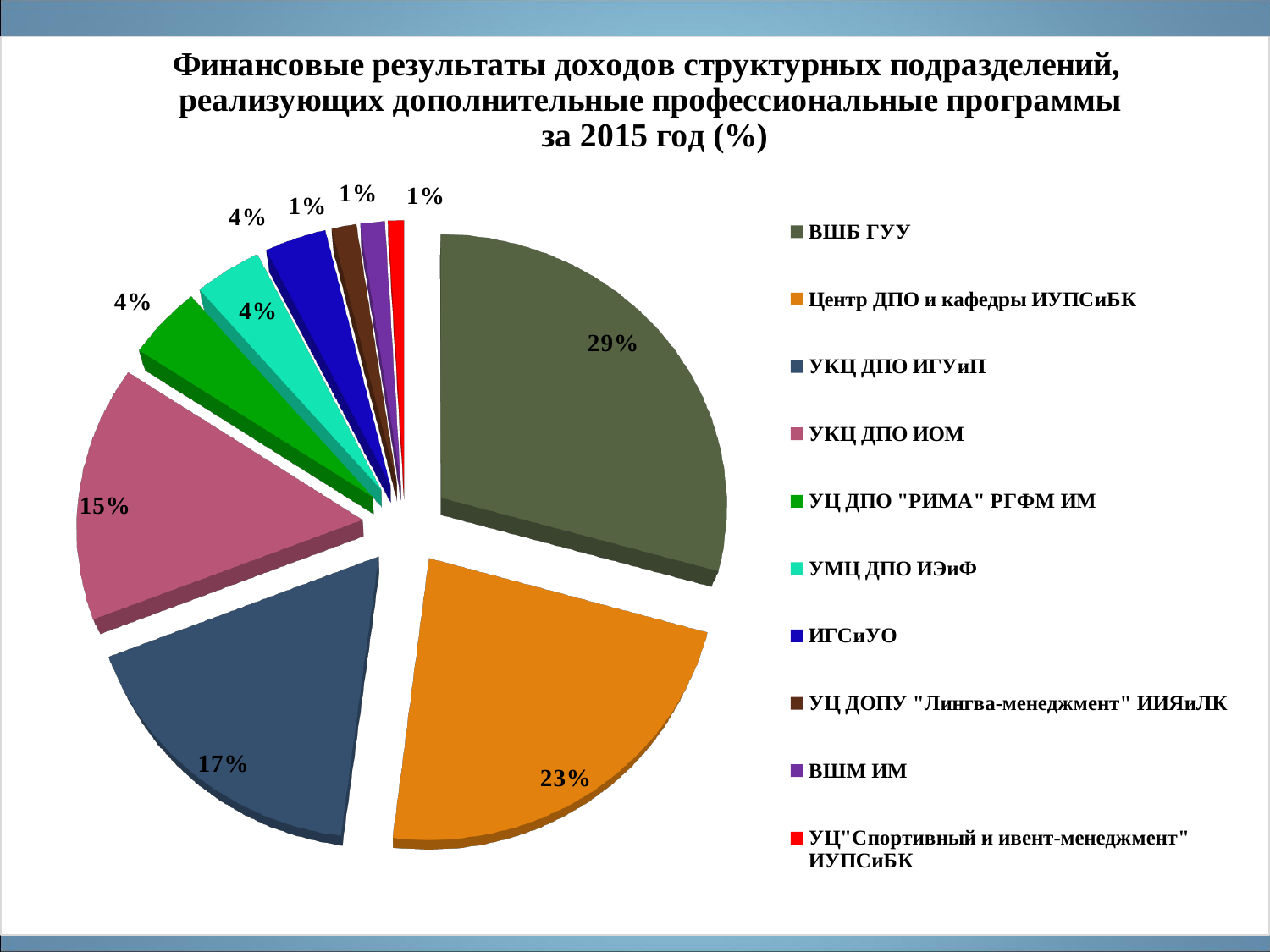
What is the value shown for Центр ДПО и кафедры ИУПСиБК? 23% What is the value shown for УКЦ ДПО ИГУиП? 17% What is the difference between the shares of ВШБ ГУУ and Центр ДПО и кафедры ИУПСиБК? 6% What is the smallest percentage shown on the pie chart? 1% How many entries does the legend list? 10 What type of chart is shown on the slide? pie chart What colour is the slice for ВШМ ИМ? purple Which structural unit has the largest share of the pie? ВШБ ГУУ What share of the pie does УМЦ ДПО ИЭиФ have? 4% What share of the pie does ВШБ ГУУ have? 29% Which has a larger share: УКЦ ДПО ИГУиП or УКЦ ДПО ИОМ? УКЦ ДПО ИГУиП What is the value shown for УКЦ ДПО ИОМ? 15%